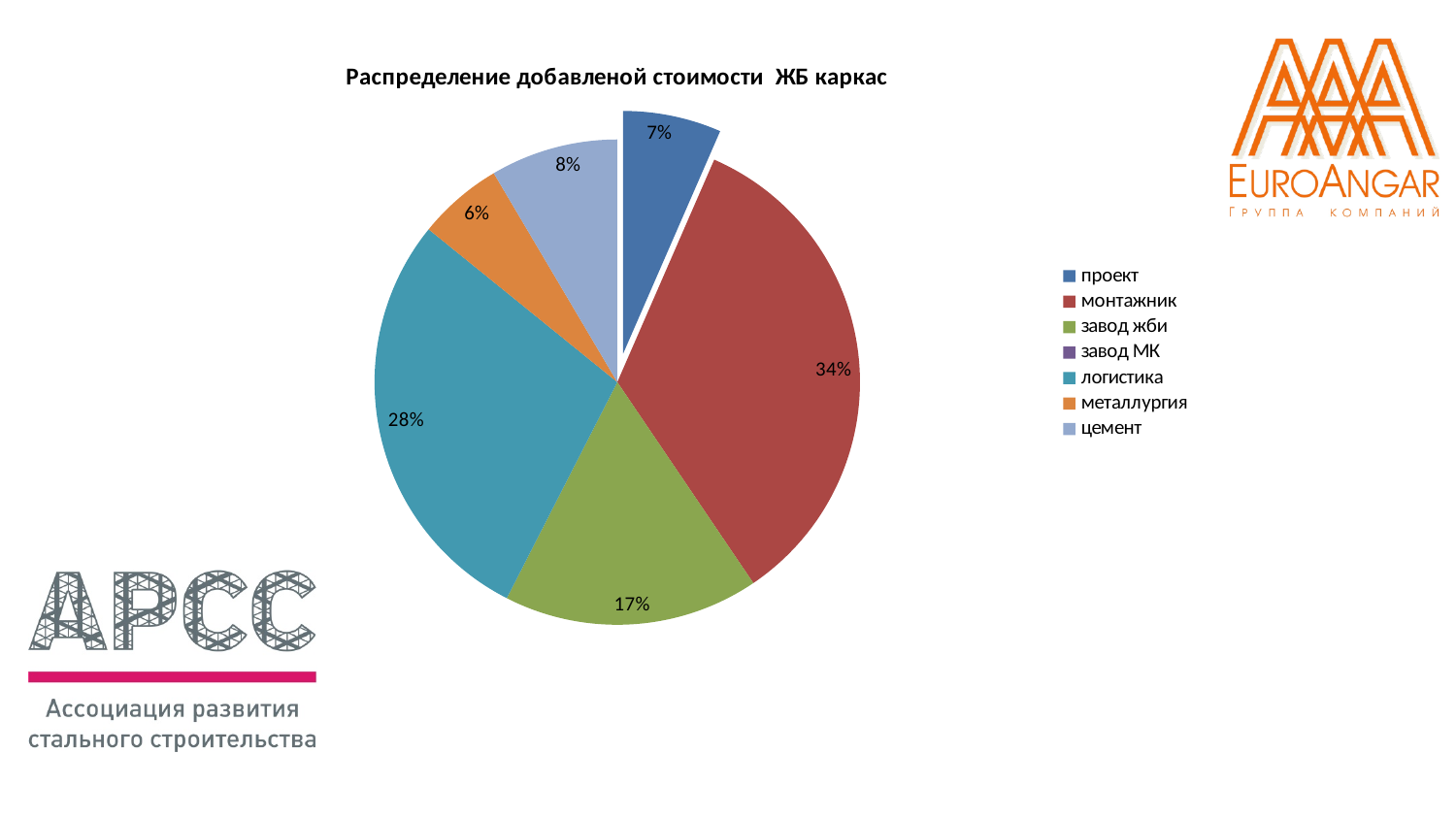
What share of the pie does цемент have? 8% What share of the pie does логистика have? 28% What is the title of the chart? Распределение добавленой стоимости ЖБ каркас What type of chart is shown on the slide? pie chart What share of the pie does монтажник have? 34% What share of the pie does проект have? 7% How many entries does the legend list? 7 Which labelled slice is the smallest in the pie? металлургия Which category has the largest slice of the pie? монтажник What is the difference in percentage points between монтажник and логистика? 6 What share of the pie does завод жби have? 17% Which is larger, the slice for цемент or the slice for металлургия? цемент